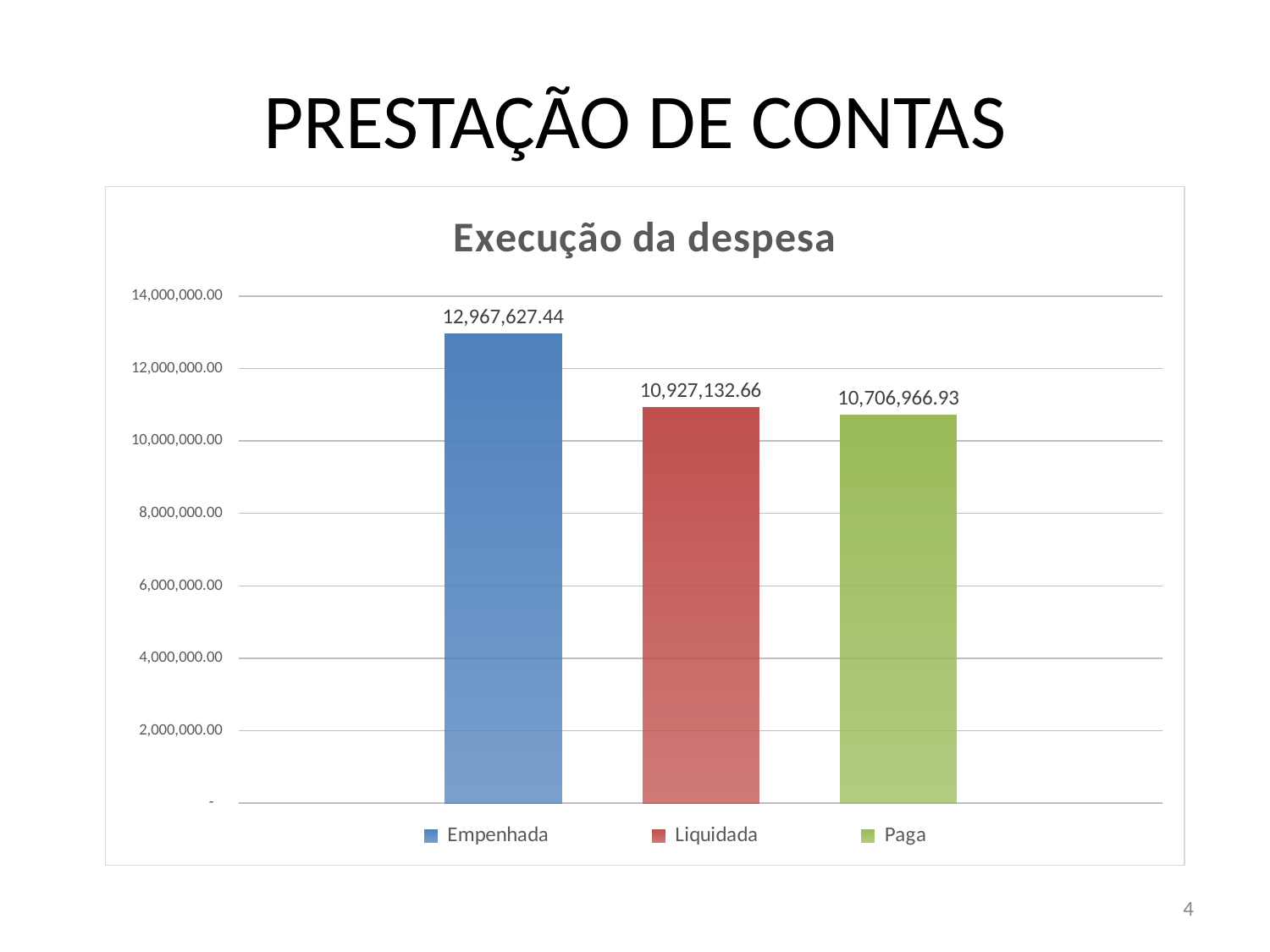
How many series does the legend list? 3 What is the value for Empenhada? 12,967,627.44 Which is larger, Liquidada or Paga? Liquidada Which category has the highest value? Empenhada Is the value for Empenhada greater or less than 12,000,000.00? greater What is the difference between the Empenhada and Liquidada values? 2,040,494.78 What is the value for Liquidada? 10,927,132.66 What is the difference between the Liquidada and Paga values? 220,165.73 Which category has the lowest value? Paga What is the value for Paga? 10,706,966.93 How many bars are shown in the chart? 3 What type of chart is shown? Bar chart